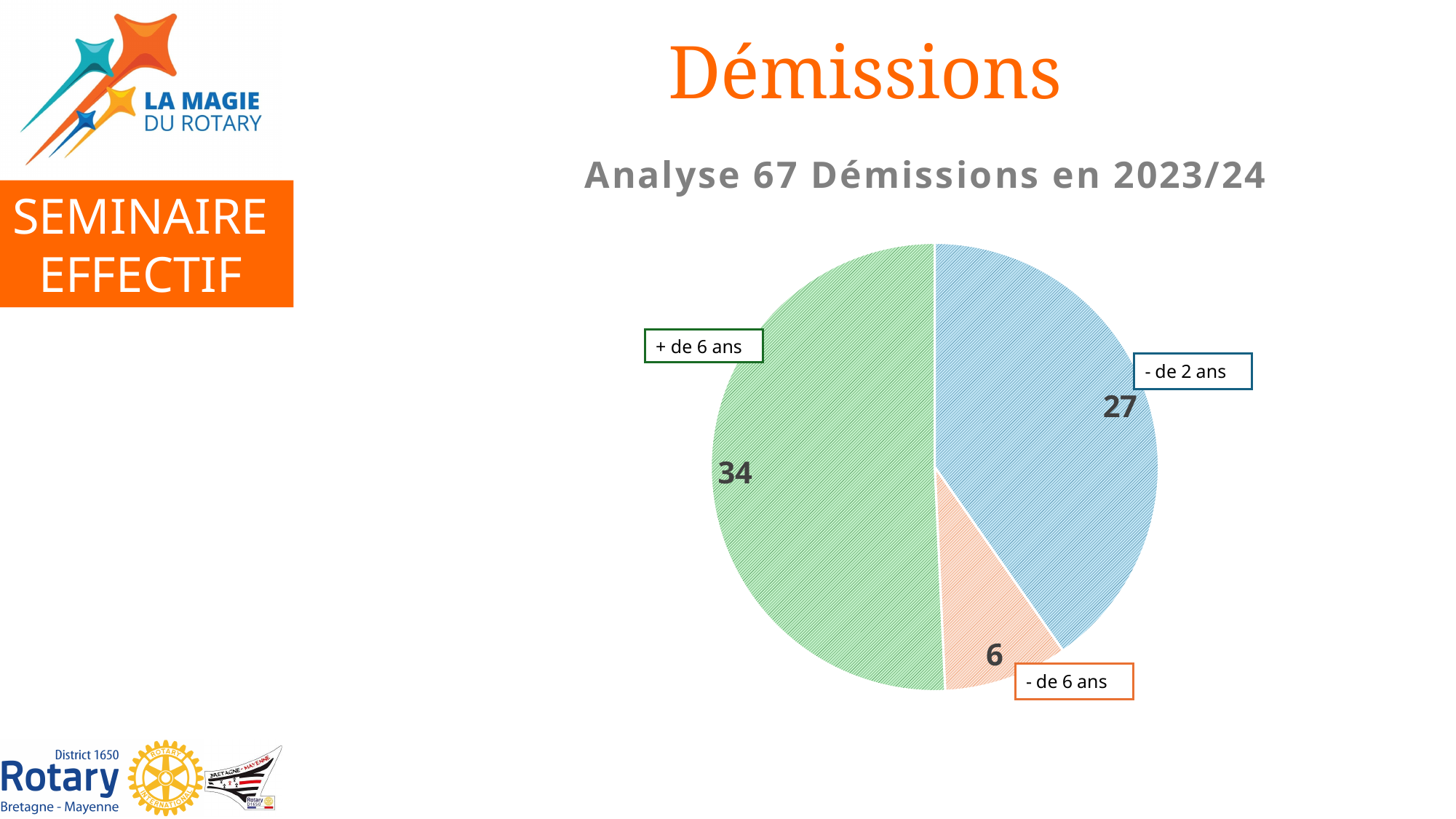
What kind of chart is shown on the slide? pie chart What is the total of all three slices in the pie chart? 67 What is the title of the chart? Analyse 67 Démissions en 2023/24 What is the value for the "- de 2 ans" slice? 27 What is the difference between the "+ de 6 ans" and "- de 2 ans" values? 7 Which category has the largest slice of the pie? + de 6 ans Which is larger, the value for "- de 2 ans" or the value for "- de 6 ans"? - de 2 ans Which category has the smallest slice of the pie? - de 6 ans What is the value for the "- de 6 ans" slice? 6 What is the value for the "+ de 6 ans" slice? 34 How many slices does the pie chart have? 3 Which colour is used for the "- de 6 ans" slice? orange